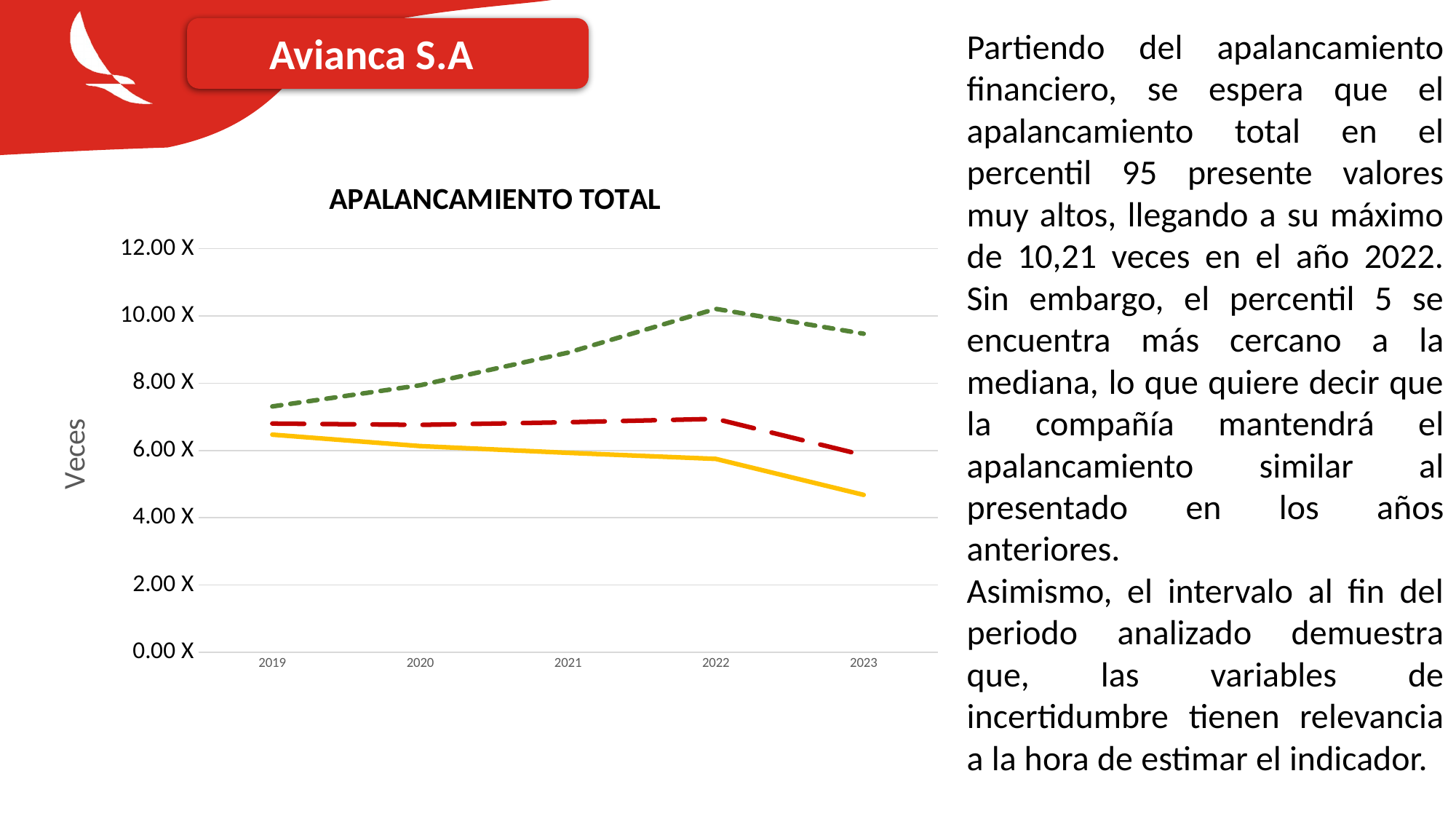
In which year does the yellow solid line reach its lowest value? 2023 Does the yellow solid line rise or fall from 2019 to 2023? fall What is the label on the vertical axis of the chart? Veces In which year does the green dotted line reach its highest value? 2022 Is the value of the red dashed line in 2022 greater or less than 6.00 X? greater What kind of chart is shown on the slide? line chart Is the value of the green dotted line in 2019 greater or less than 8.00 X? less How many years are shown on the x axis of the chart? 5 What is the title of the chart? APALANCAMIENTO TOTAL How many lines are plotted on the chart? 3 Is the value of the yellow solid line in 2023 greater or less than 4.00 X? greater In 2023, which line has the higher value, the green dotted line or the yellow solid line? green dotted line